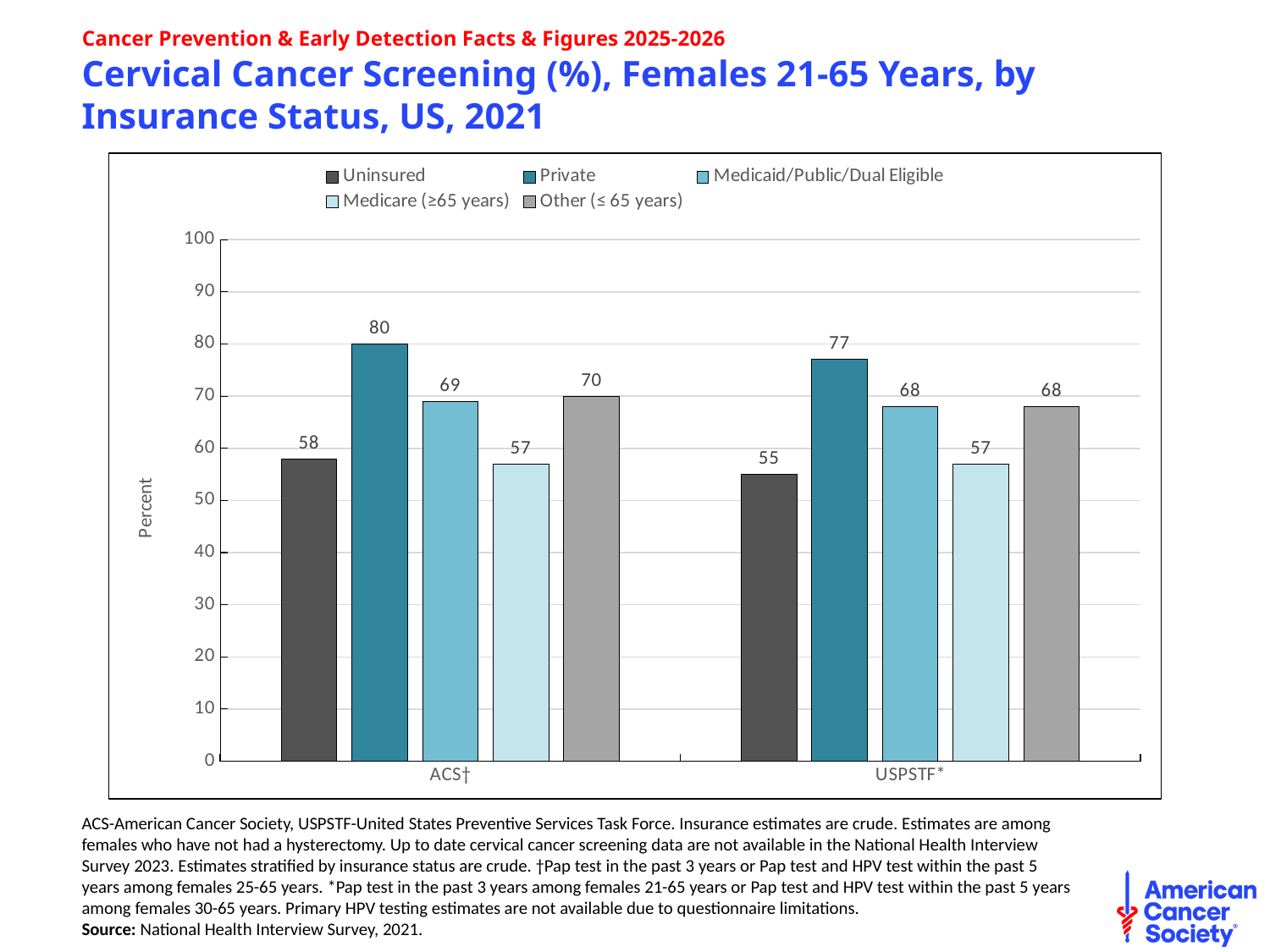
What is the value for Other (≤ 65 years) under the ACS† guideline? 70 Which insurance status has the highest screening percentage under the USPSTF* guideline? Private How many categories are shown on the x axis? 2 What kind of chart is shown on the slide? Bar chart Which is larger under the USPSTF* guideline: Medicaid/Public/Dual Eligible or Medicare (≥65 years)? Medicaid/Public/Dual Eligible What is the difference between the Private values for ACS† and USPSTF*? 3 What is the cervical cancer screening percentage for Private insurance under the ACS† guideline? 80 What is the difference between the Private and Uninsured values under the ACS† guideline? 22 Which insurance status has the lowest screening percentage under the ACS† guideline? Medicare (≥65 years) What is the value for Uninsured under the USPSTF* guideline? 55 How many series does the legend list? 5 What is the label of the y axis? Percent